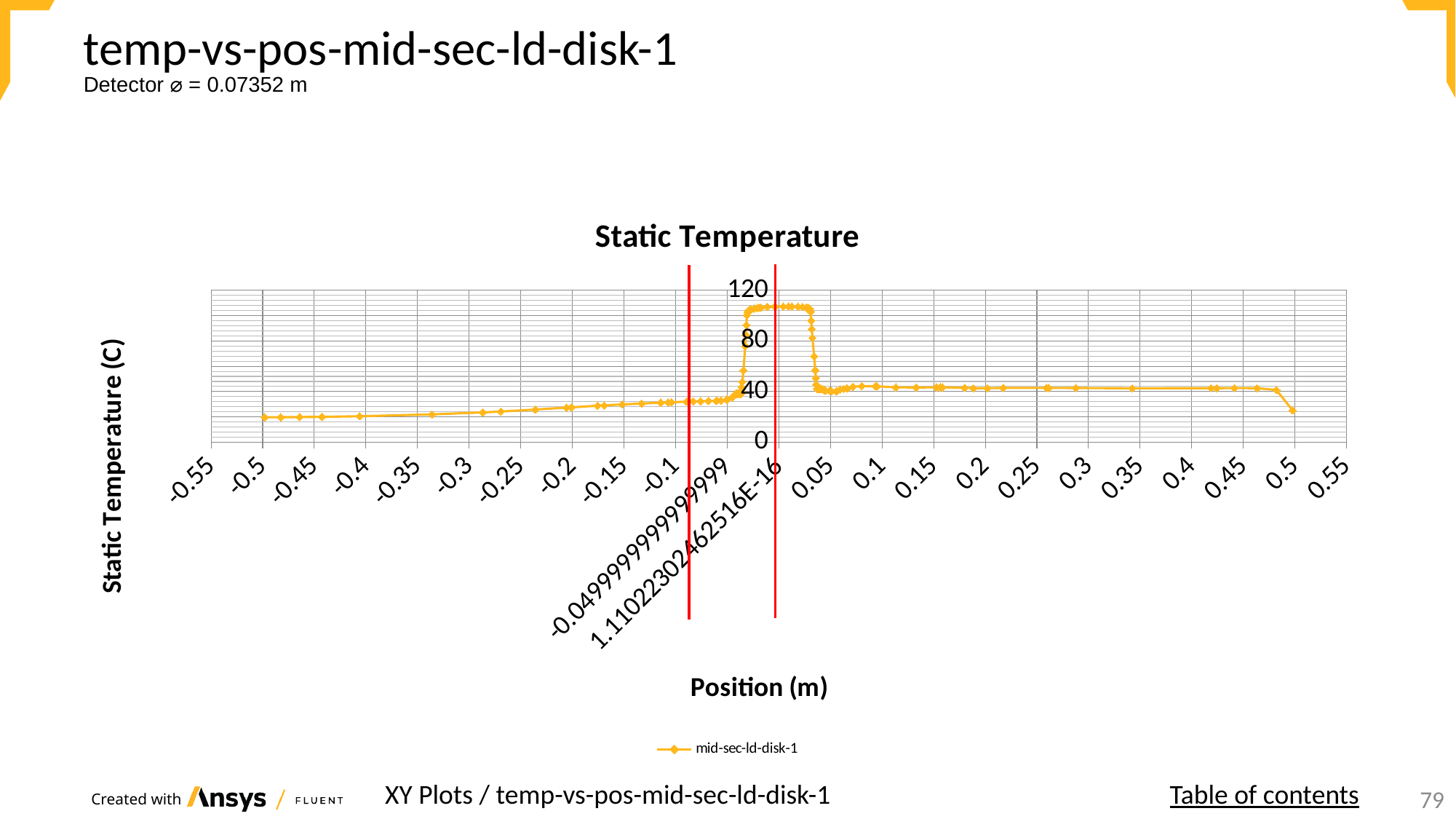
Which is larger: the value at position -0.5 or the value at position 0.3? 0.3 What is the title of the chart? Static Temperature Which is larger: the value at position 0.3 or the peak value near position 0? the peak near position 0 Do the values rise or fall as position increases from -0.5 to -0.1? rise Is the peak value of the series near position 0 greater or less than 80? greater How many series does the legend list? 1 What is the name of the series in the legend? mid-sec-ld-disk-1 Is the value for position 0.5 greater or less than 40? less What kind of chart is shown on the slide? line chart Is the value for position -0.5 greater or less than 40? less